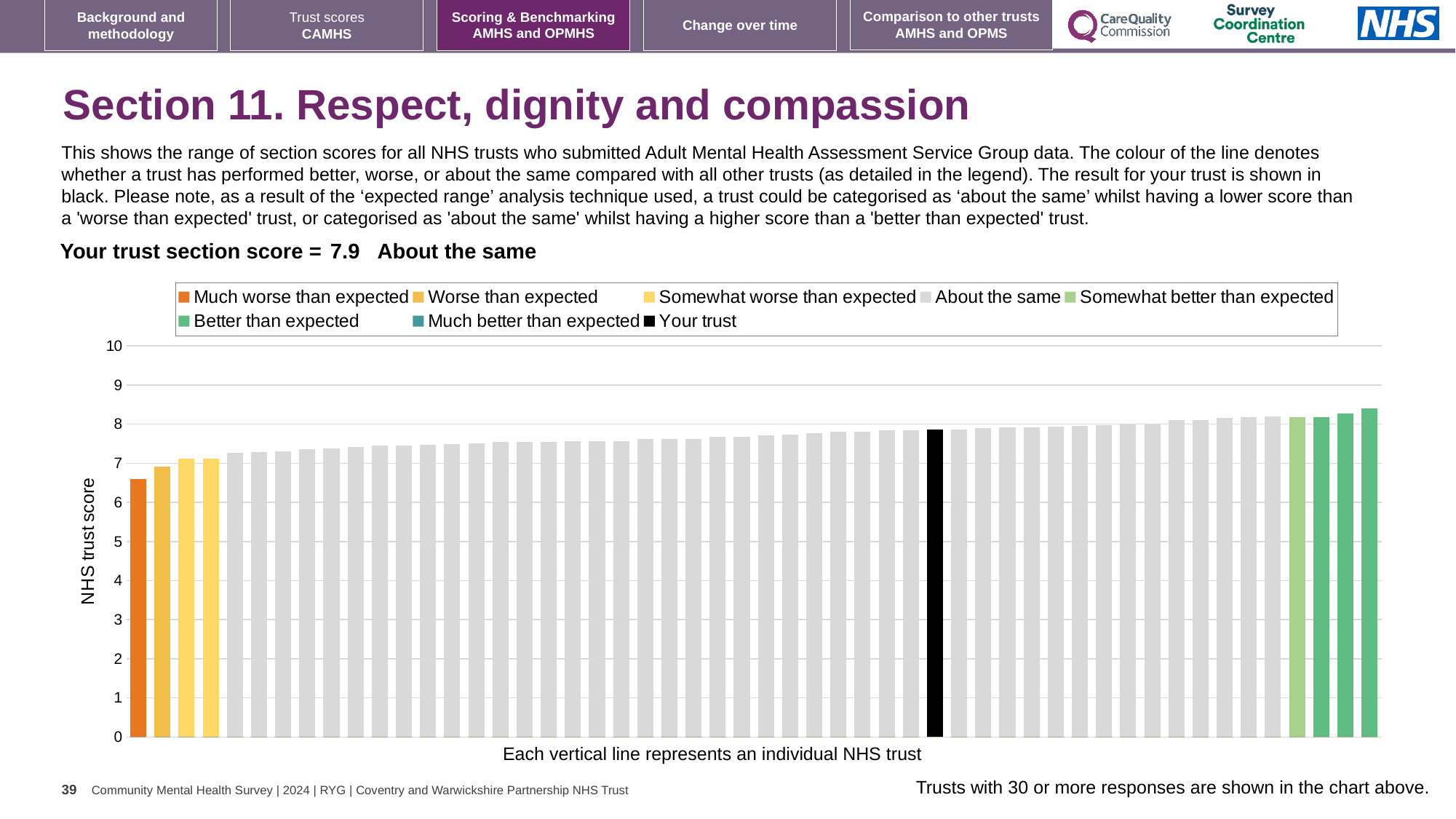
What is your trust's section score for Section 11, Respect, dignity and compassion? 7.9 What colour is used for the bar representing your trust? black What is the label on the vertical axis of the chart? NHS trust score Is the value of the tallest bar on the chart greater or less than 8? greater How many bars on the chart are coloured orange (Much worse than expected)? 1 Is the value of the black 'Your trust' bar greater or less than 7? greater What kind of chart is shown on the slide? bar chart How many entries does the chart legend list? 8 Is the value of the orange 'Much worse than expected' bar greater or less than 7? less Which performance category is your trust placed in for this section? About the same Do the bar values rise or fall moving from left to right along the x axis? rise Which legend category do the tallest bars on the right of the chart belong to? Better than expected